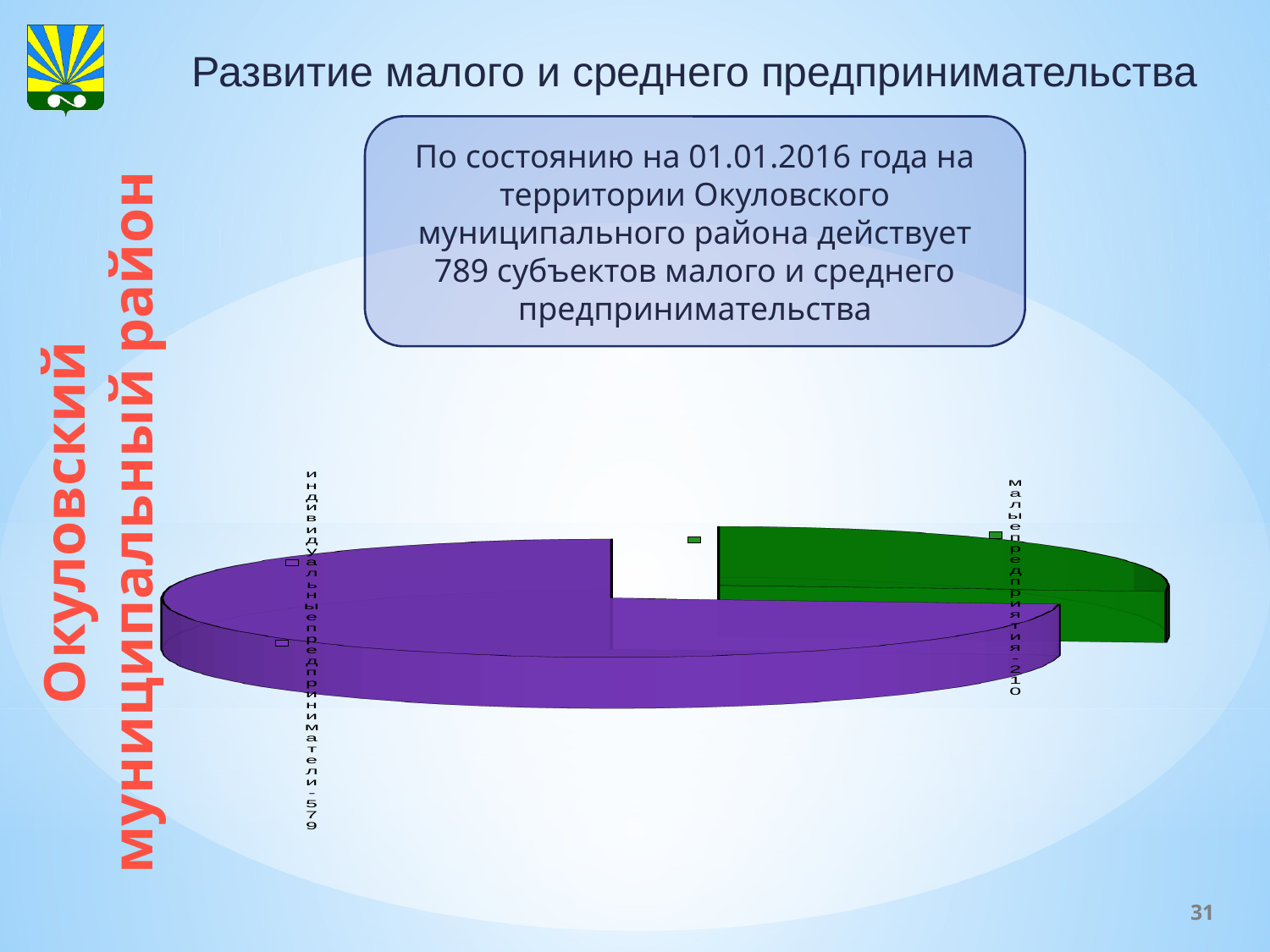
What value is shown for индивидуальные предприниматели in the pie chart? 579 What is the total of the two values shown in the pie chart? 789 What kind of chart is shown on the slide? Pie chart What colour is the slice for индивидуальные предприниматели? Purple What colour is the slice for малые предприятия? Green Which is larger: the value for индивидуальные предприниматели or the value for малые предприятия? индивидуальные предприниматели Which category has the largest slice in the pie chart? индивидуальные предприниматели What is the difference between the values for индивидуальные предприниматели and малые предприятия? 369 How many slices (categories) does the pie chart have? 2 What value is shown for малые предприятия in the pie chart? 210 Which category has the smallest slice in the pie chart? малые предприятия